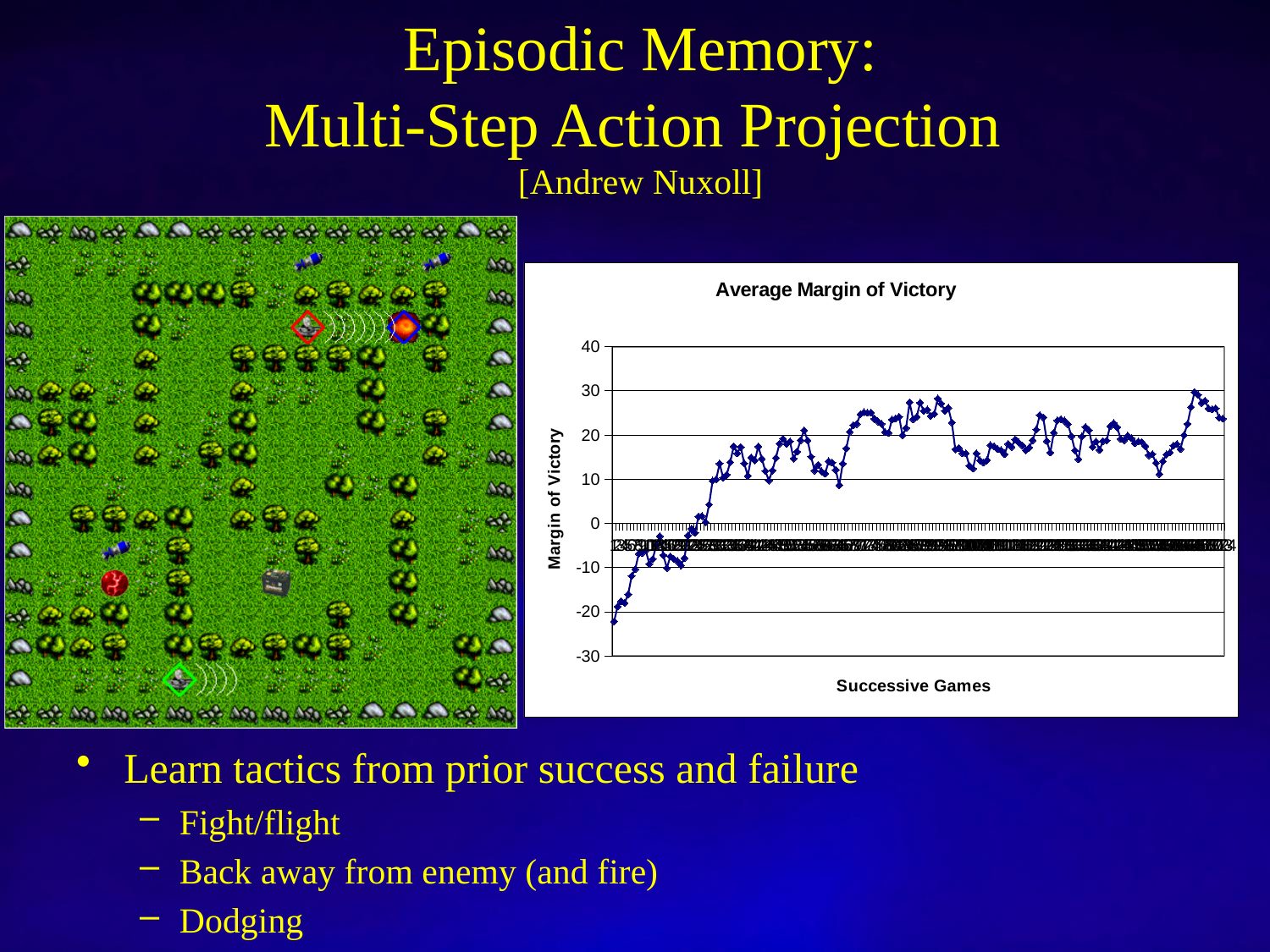
What is the title of the chart? Average Margin of Victory Is the lowest value plotted in the chart greater or less than -30? greater Is the value for the first game in the chart greater or less than -10? less Is the value for the last game in the chart greater or less than 10? greater Do the values in the chart generally rise or fall along the x axis? rise Which is larger in the chart, the value for the first game or the value for the last game? the last game What is the label on the vertical axis of the chart? Margin of Victory What kind of chart is shown on the slide? line chart